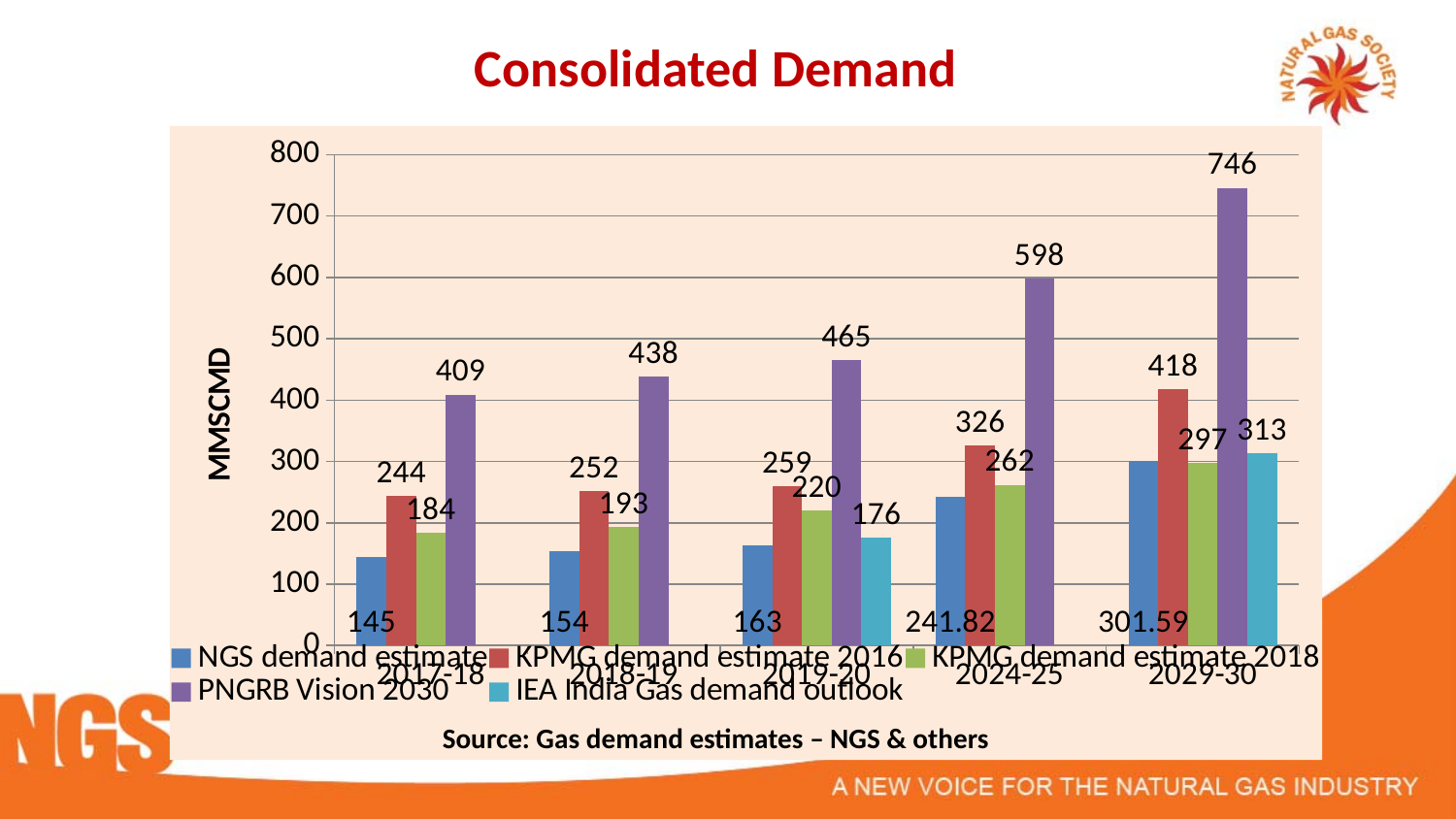
Do the KPMG demand estimate 2016 values rise or fall from 2017-18 to 2029-30? Rise How many series does the legend list? 5 What is the IEA India Gas demand outlook value for 2029-30? 313 What is the KPMG demand estimate 2016 value for 2019-20? 259 What is the PNGRB Vision 2030 value for 2029-30? 746 What is the difference between the PNGRB Vision 2030 values for 2029-30 and 2024-25? 148 What is the NGS demand estimate for 2024-25? 241.82 Which year has the highest PNGRB Vision 2030 value? 2029-30 How many year categories are shown on the x axis? 5 Which year has the lowest NGS demand estimate? 2017-18 Which is larger for 2018-19: the KPMG demand estimate 2016 or the KPMG demand estimate 2018? KPMG demand estimate 2016 What kind of chart is shown on the slide? Bar chart